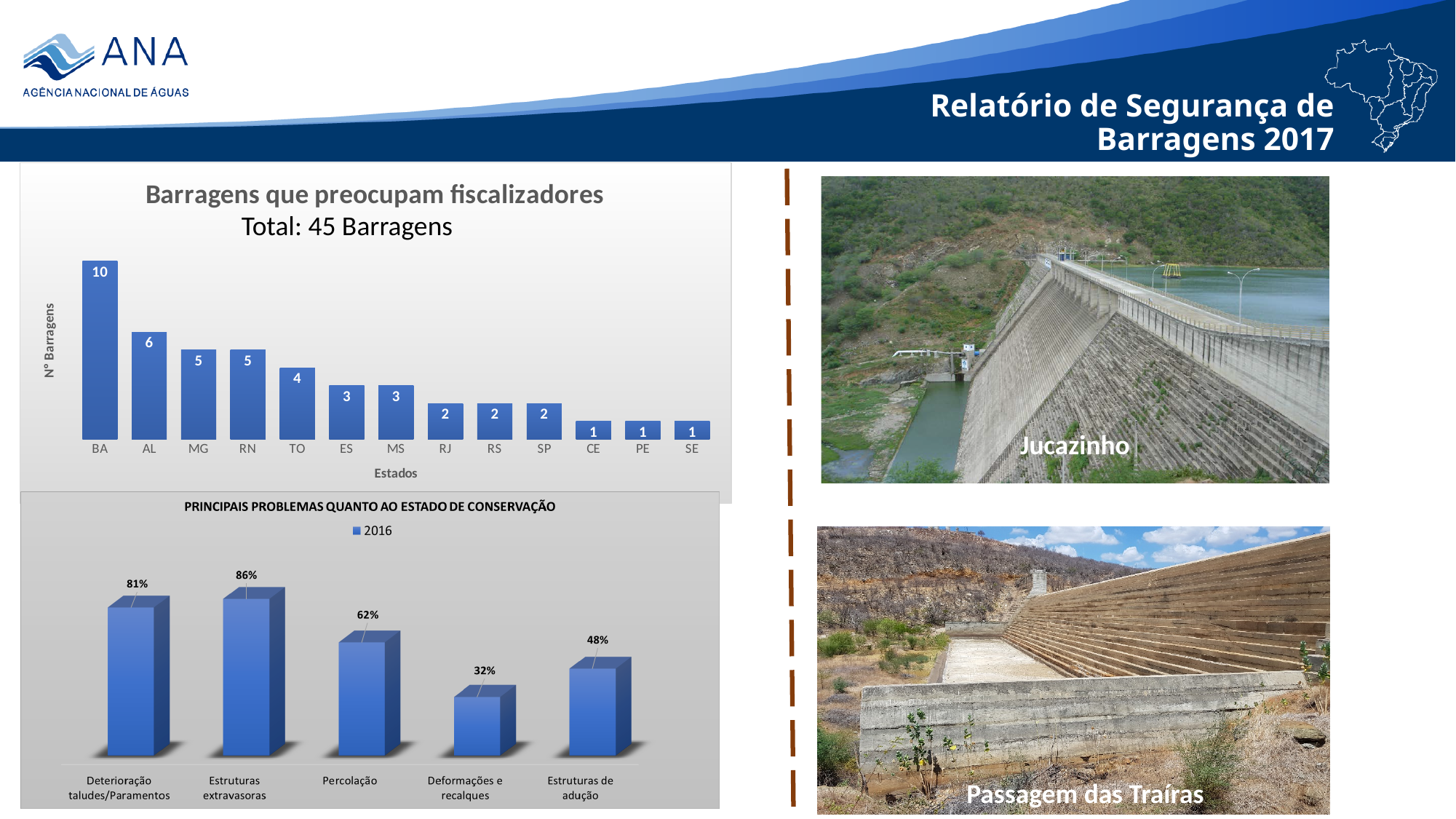
In the chart 'PRINCIPAIS PROBLEMAS QUANTO AO ESTADO DE CONSERVAÇÃO', what year does the legend list? 2016 In the chart 'PRINCIPAIS PROBLEMAS QUANTO AO ESTADO DE CONSERVAÇÃO', what is the difference between the values for Estruturas extravasoras and Deterioração taludes/Paramentos? 5% In the chart 'Barragens que preocupam fiscalizadores', what is the difference between the values for BA and AL? 4 In the chart 'Barragens que preocupam fiscalizadores', how many barragens are shown for BA? 10 In the chart 'Barragens que preocupam fiscalizadores', what is the value for TO? 4 In the chart 'Barragens que preocupam fiscalizadores', do the values rise or fall from left to right along the x axis? fall In the chart 'PRINCIPAIS PROBLEMAS QUANTO AO ESTADO DE CONSERVAÇÃO', which category has the highest value? Estruturas extravasoras In the chart 'PRINCIPAIS PROBLEMAS QUANTO AO ESTADO DE CONSERVAÇÃO', what is the value for Percolação? 62% In the chart 'Barragens que preocupam fiscalizadores', which state has the highest number of barragens? BA In the chart 'Barragens que preocupam fiscalizadores', how many states are shown on the x axis? 13 In the chart 'PRINCIPAIS PROBLEMAS QUANTO AO ESTADO DE CONSERVAÇÃO', which category has the lowest value? Deformações e recalques In the chart 'Barragens que preocupam fiscalizadores', which is larger, the value for MG or the value for ES? MG